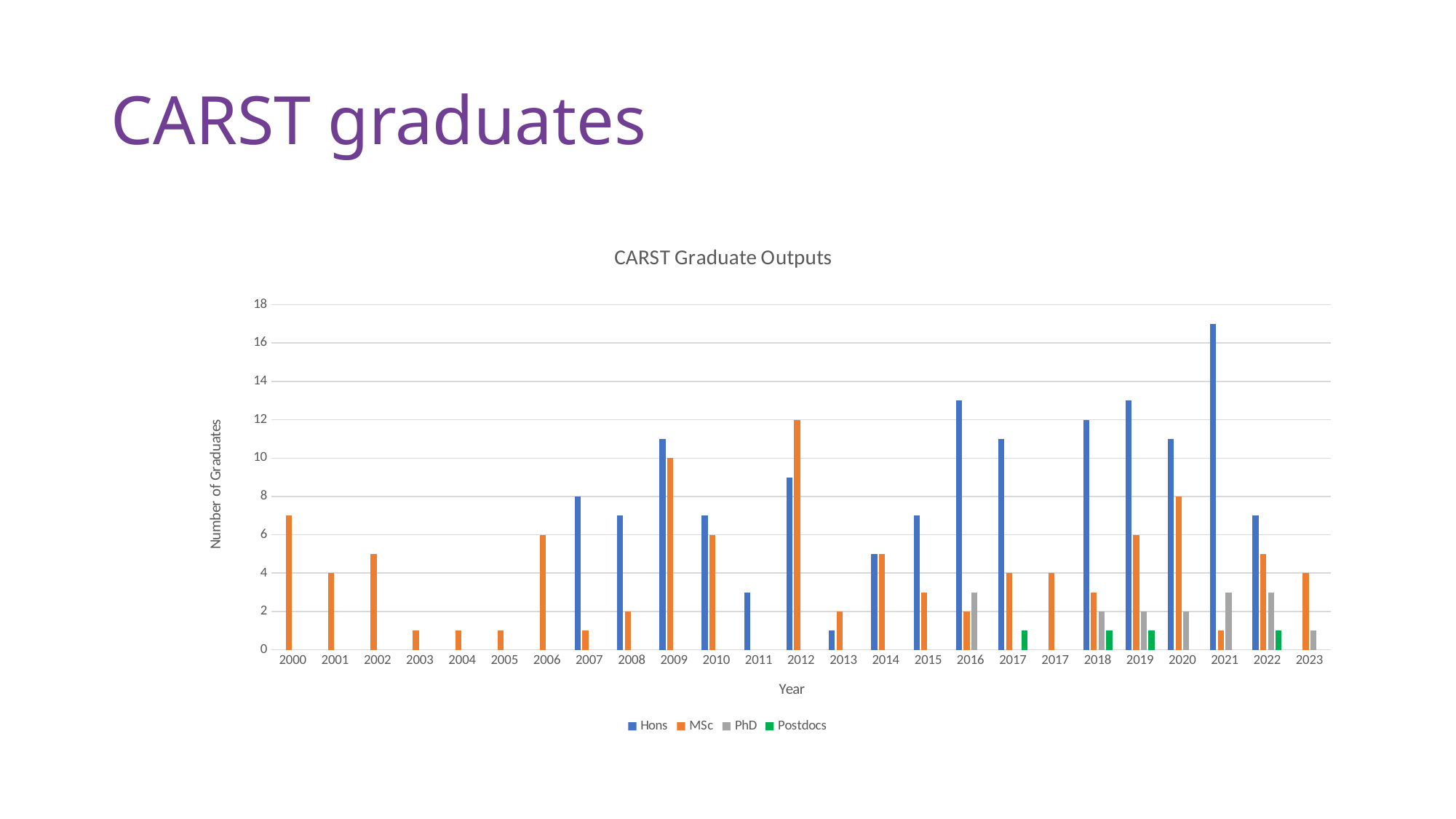
What is the title of the chart? CARST Graduate Outputs In which year is the Hons bar the highest? 2021 What is the MSc value for 2009? 10 What is the label of the vertical axis? Number of Graduates How many series does the legend list? 4 What type of chart is shown on the slide? bar chart Which is larger in 2012, the Hons value or the MSc value? MSc What is the MSc value for 2012? 12 Is the Hons value for 2011 greater or less than 4? less Is the Hons value for 2021 greater or less than 16? greater What is the Hons value for 2007? 8 What is the MSc value for 2020? 8